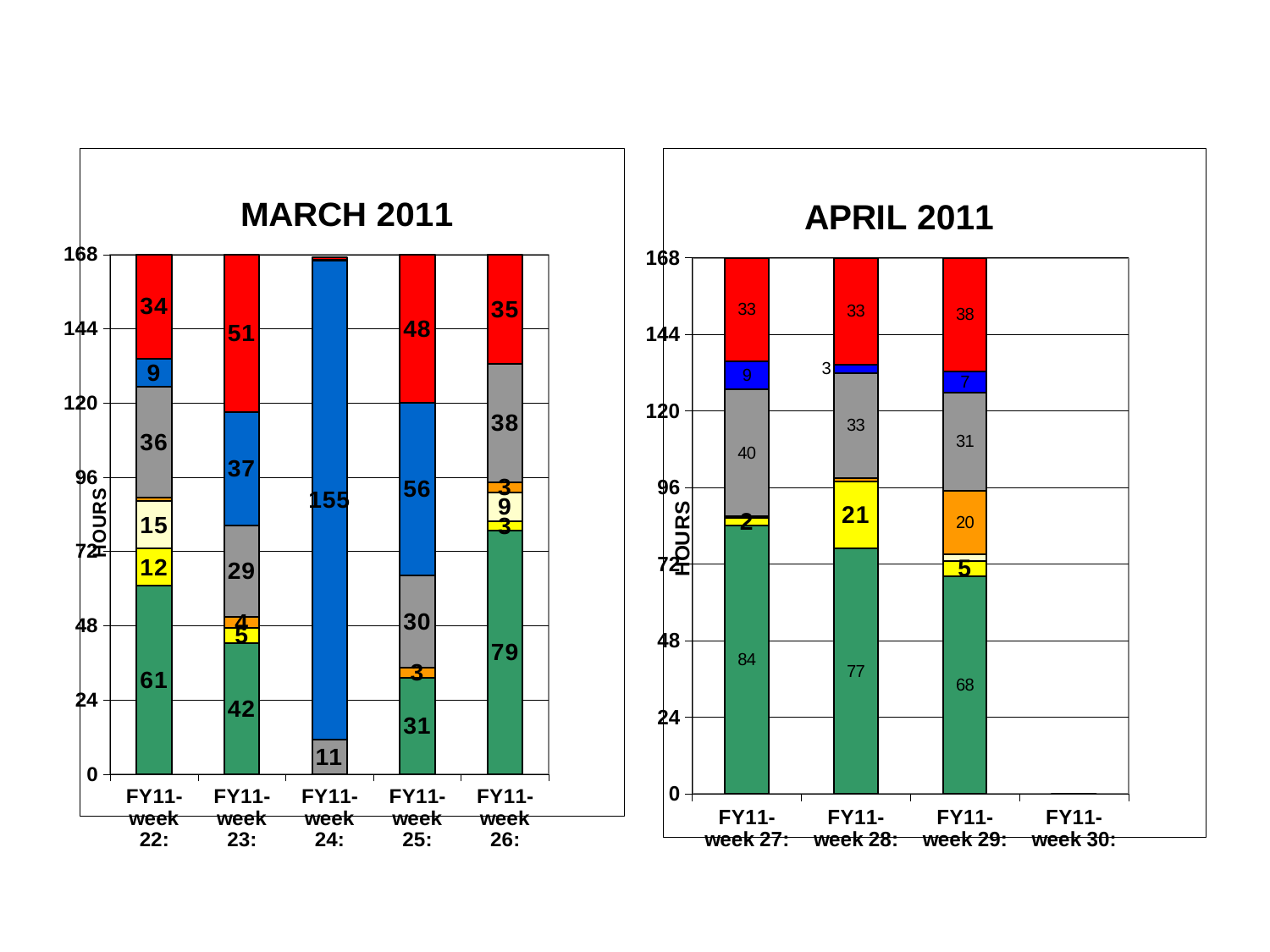
On the APRIL 2011 chart, what is the value of the orange segment for FY11-week 29? 20 On the APRIL 2011 chart, which week has the smallest green segment among the weeks with data? FY11-week 29 What type of chart is the APRIL 2011 chart? Stacked bar chart On the MARCH 2011 chart, which week has the largest green segment? FY11-week 26 On the MARCH 2011 chart, what is the value of the blue segment for FY11-week 24? 155 What is the y-axis label on the MARCH 2011 chart? HOURS How many week categories are shown on the x axis of the MARCH 2011 chart? 5 On the APRIL 2011 chart, what is the difference between the green segments of FY11-week 27 and FY11-week 28? 7 On the MARCH 2011 chart, what is the value of the green segment for FY11-week 22? 61 On the MARCH 2011 chart, is the red segment larger for FY11-week 23 or FY11-week 22? FY11-week 23 On the MARCH 2011 chart, what is the value of the red segment for FY11-week 23? 51 On the APRIL 2011 chart, what is the value of the green segment for FY11-week 29? 68